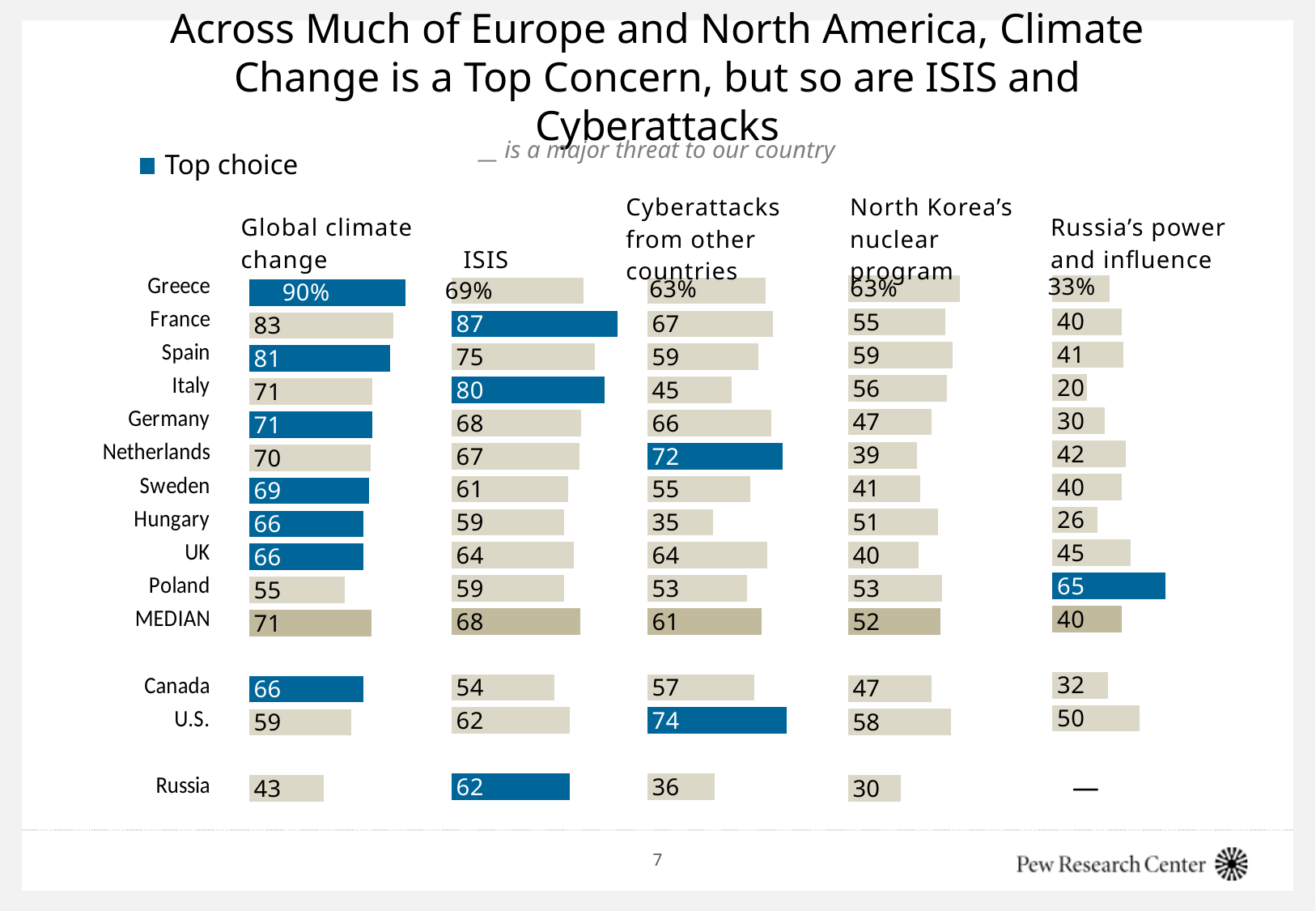
What does the legend entry for the dark blue bars say? Top choice In the Cyberattacks from other countries chart, which is larger, the value for Hungary or the value for Russia? Russia In the Russia's power and influence chart, which country has the highest value? Poland In the Cyberattacks from other countries chart, what is the value for the U.S.? 74 In the North Korea's nuclear program chart, what is the MEDIAN value? 52 In the Global climate change chart, what percentage of people in Greece say it is a major threat? 90% In the North Korea's nuclear program chart, what is the difference between the values for Greece and Russia? 33 What kind of chart is used to show the values on this slide? Bar chart In the ISIS chart, what is the value for France? 87 In the Global climate change chart, what is the difference between the values for Greece and Russia? 47 In the ISIS chart, which is larger, the value for Italy or the value for Spain? Italy In the Russia's power and influence chart, which country has the lowest value? Italy